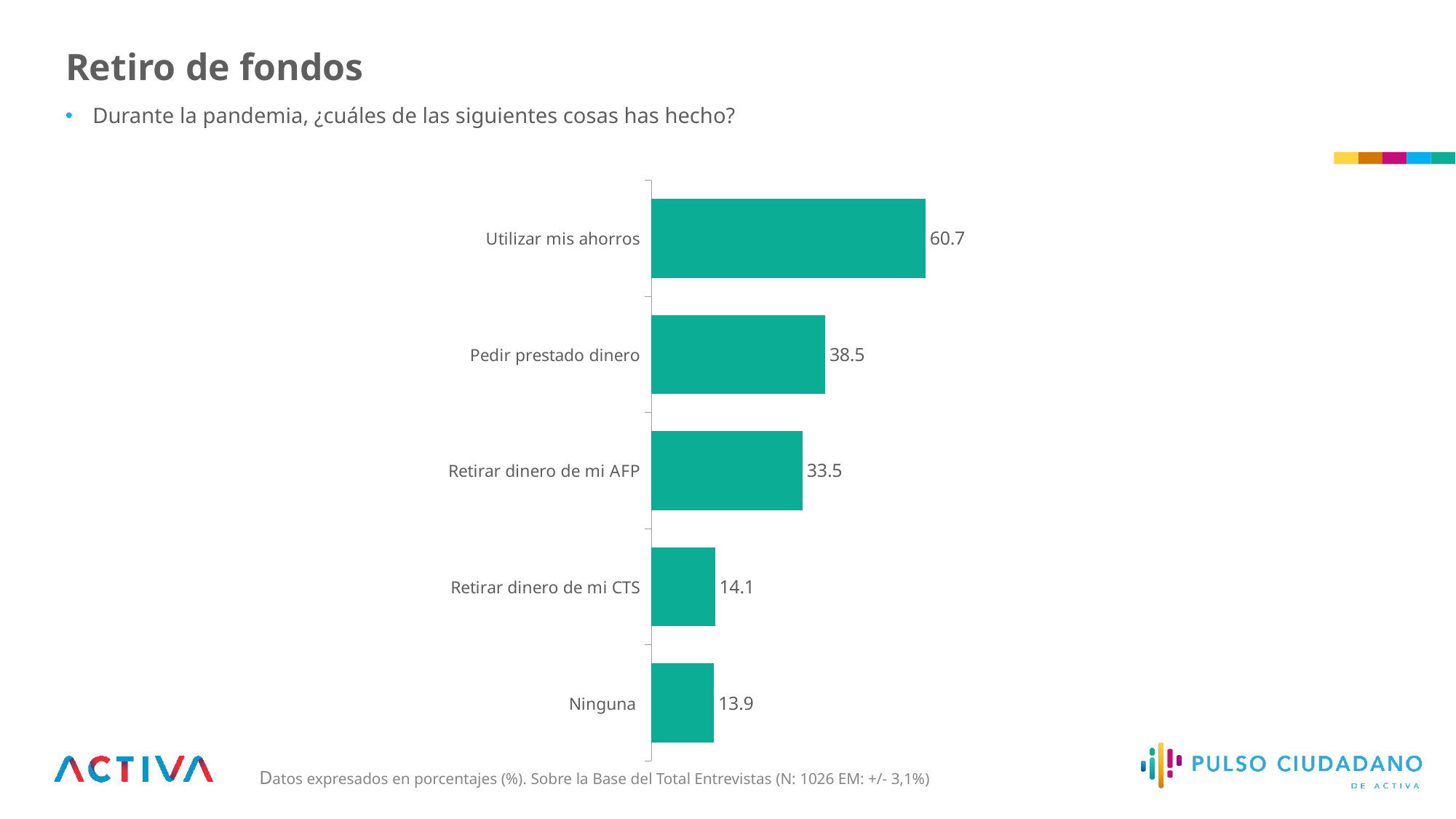
What is the value for "Utilizar mis ahorros"? 60.7 Which category has the highest value? Utilizar mis ahorros What is the value for "Retirar dinero de mi CTS"? 14.1 What is the value for "Ninguna"? 13.9 What is the value for "Pedir prestado dinero"? 38.5 What is the title of the slide containing the chart? Retiro de fondos Which is larger, the value for "Pedir prestado dinero" or the value for "Retirar dinero de mi AFP"? Pedir prestado dinero What is the value for "Retirar dinero de mi AFP"? 33.5 How many categories are shown in the chart? 5 What kind of chart is shown on the slide? Bar chart What is the difference between the values for "Utilizar mis ahorros" and "Pedir prestado dinero"? 22.2 Which category has the lowest value? Ninguna